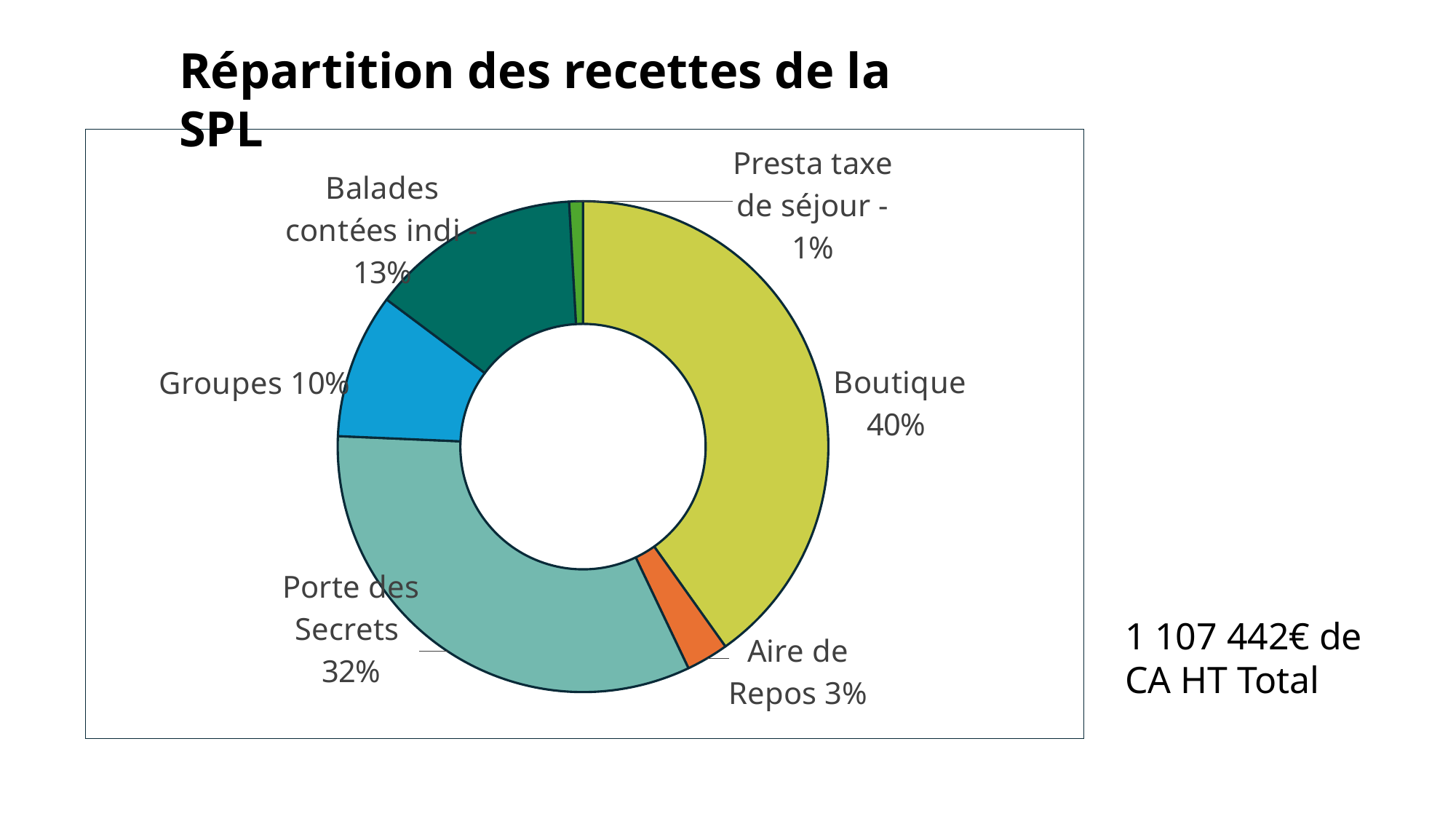
What share of revenue does Porte des Secrets account for? 32% How many categories are shown in the chart? 6 What share of revenue does Boutique account for? 40% What is the title of the chart? Répartition des recettes de la SPL What percentage is shown for Aire de Repos? 3% What kind of chart is shown on the slide? Doughnut (pie) chart Which is larger, the share for Groupes or the share for Balades contées indi? Balades contées indi What is the difference in percentage points between Boutique and Porte des Secrets? 8 What percentage is shown for Groupes? 10% Which category has the smallest share of revenue? Presta taxe de séjour Which category has the largest share of revenue? Boutique What percentage is shown for Balades contées indi? 13%